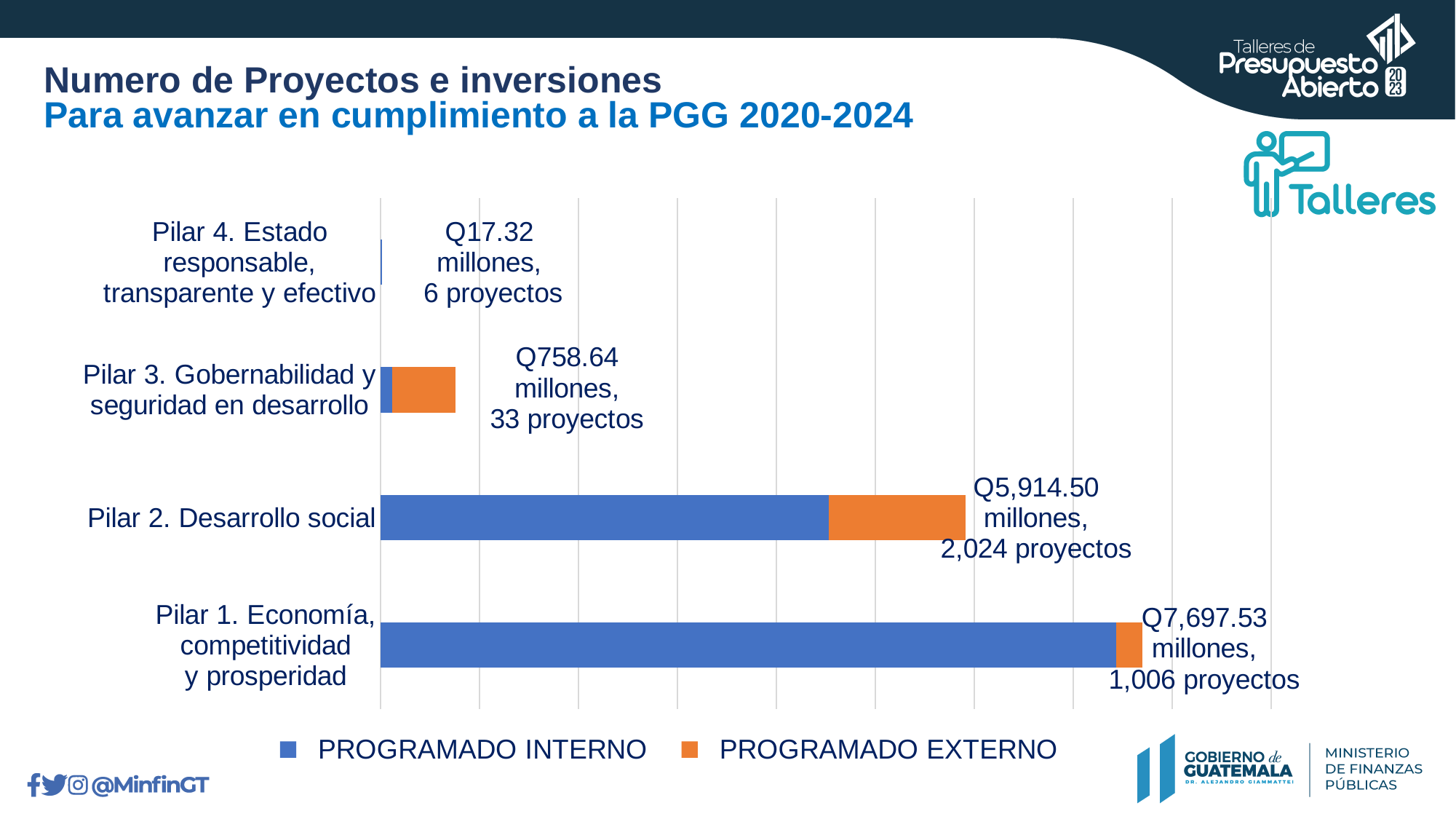
What is the difference in total investment between Pilar 1 and Pilar 2, in millones? Q1,783.03 millones What total investment is labelled for Pilar 2. Desarrollo social? Q5,914.50 millones How many series does the legend list? 2 Which pillar has the largest number of projects? Pilar 2. Desarrollo social How many projects are labelled for Pilar 3. Gobernabilidad y seguridad en desarrollo? 33 proyectos How many more projects does Pilar 2 have than Pilar 1? 1,018 Which pillar has the smallest total investment? Pilar 4. Estado responsable, transparente y efectivo In Pilar 3, which is larger: PROGRAMADO INTERNO or PROGRAMADO EXTERNO? PROGRAMADO EXTERNO How many pillars (categories) are shown in the chart? 4 What total investment is labelled for Pilar 1. Economía, competitividad y prosperidad? Q7,697.53 millones How many projects are labelled for Pilar 4. Estado responsable, transparente y efectivo? 6 proyectos Which pillar has the largest total investment? Pilar 1. Economía, competitividad y prosperidad